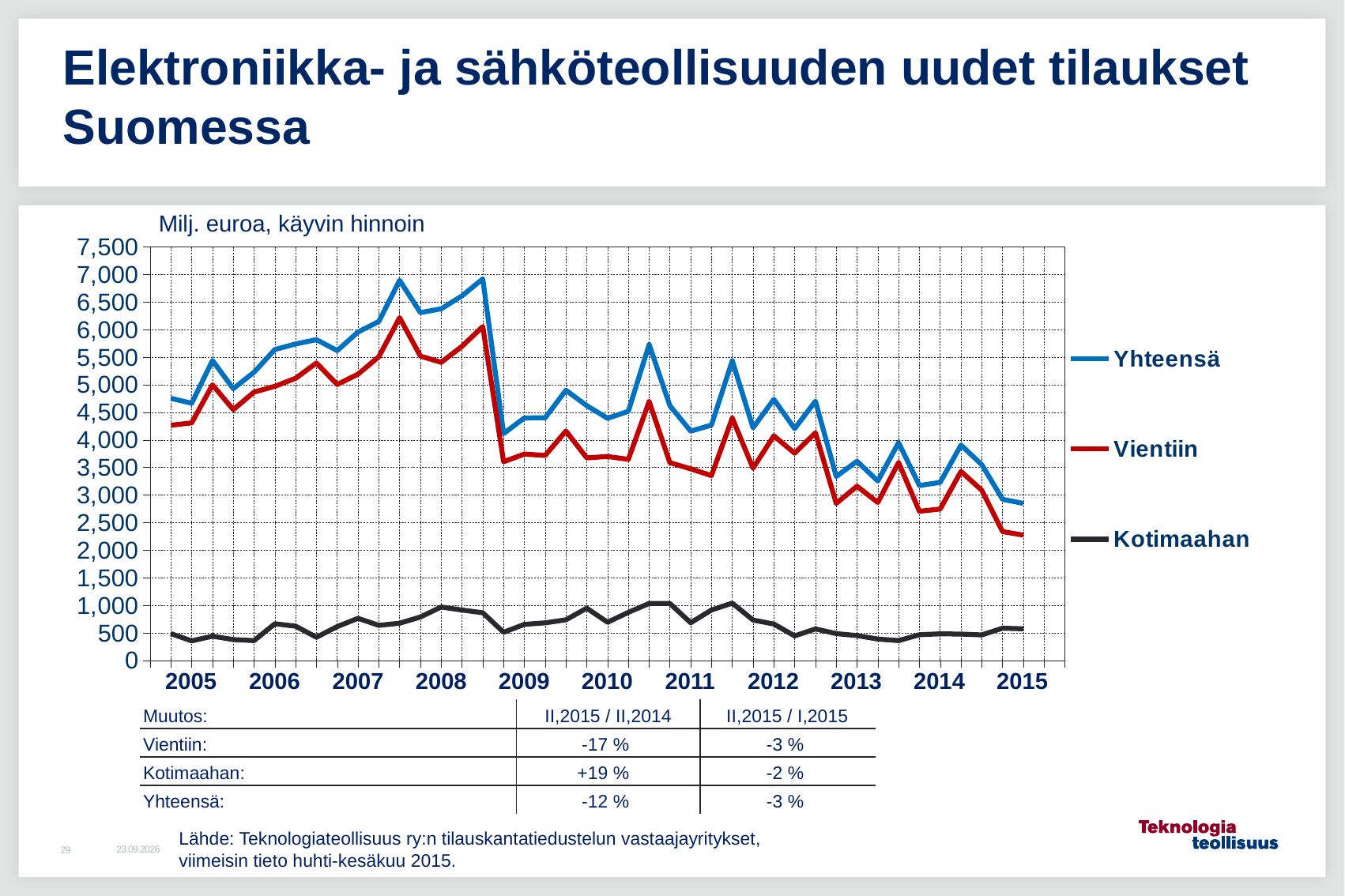
Is the value for Vientiin at the end of 2015 greater or less than 2,500? less How many year labels are shown on the x axis? 11 What kind of chart is shown on the slide? line chart Is the value for Kotimaahan in 2015 greater or less than 1,000? less Which series has the highest values throughout the chart? Yhteensä How many series does the legend list? 3 What are the three series named in the legend? Yhteensä, Vientiin, Kotimaahan Is the highest value of Yhteensä greater or less than 6,500? greater According to the table below the chart, what is the change for Vientiin II,2015 / II,2014? -17 % Does the Yhteensä series rise or fall overall from 2011 to 2015? fall Which series has the lowest values throughout the chart? Kotimaahan What unit is stated above the chart? Milj. euroa, käyvin hinnoin